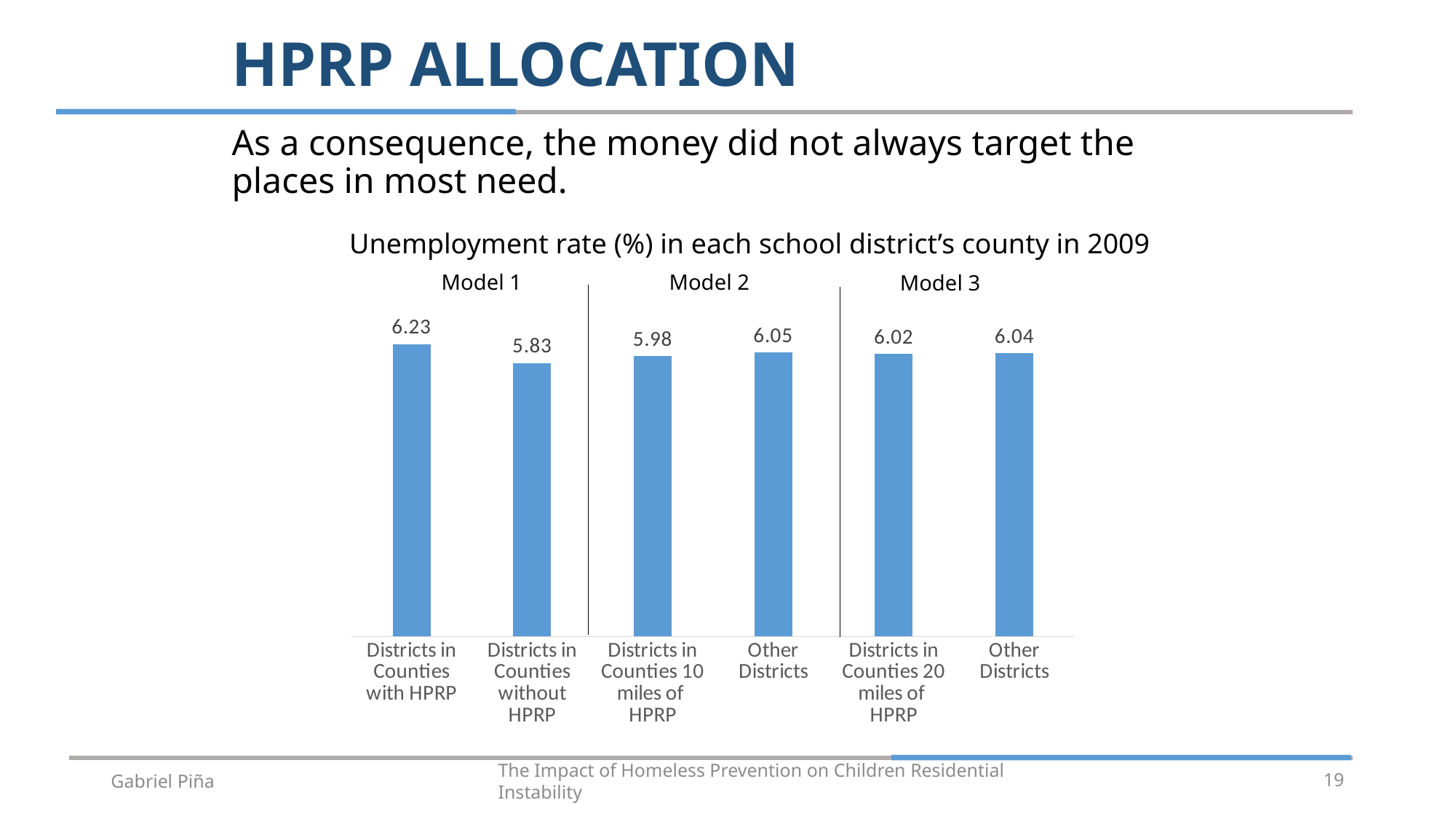
What is the difference between the unemployment rates for Districts in Counties with HPRP and Districts in Counties without HPRP in Model 1? 0.40 What is the unemployment rate for Districts in Counties 10 miles of HPRP in Model 2? 5.98 What is the unemployment rate for Districts in Counties with HPRP in Model 1? 6.23 What is the difference between the unemployment rates for Other Districts and Districts in Counties 10 miles of HPRP in Model 2? 0.07 Which bar has the highest unemployment rate in the chart? Districts in Counties with HPRP (Model 1) What is the unemployment rate for Districts in Counties without HPRP in Model 1? 5.83 Which bar has the lowest unemployment rate in the chart? Districts in Counties without HPRP (Model 1) What is the unemployment rate for Other Districts in Model 3? 6.04 What is the title of the chart? Unemployment rate (%) in each school district's county in 2009 How many bars are plotted in the chart? 6 In Model 2, which has the higher unemployment rate: Districts in Counties 10 miles of HPRP or Other Districts? Other Districts What kind of chart is shown on the slide? Bar chart